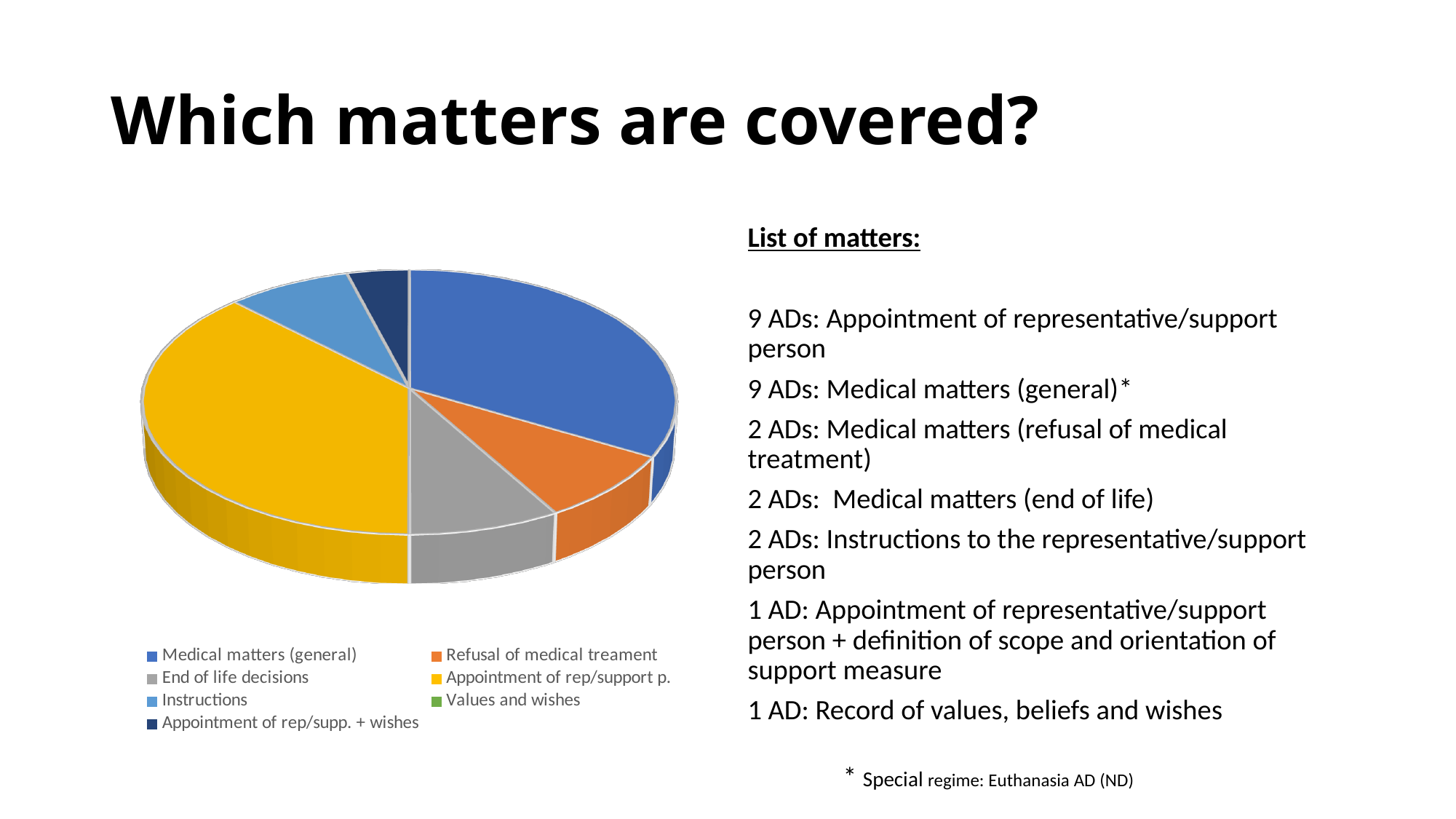
What is the title of the slide containing the pie chart? Which matters are covered? How many categories does the pie chart's legend list? 7 Which is larger in the pie chart: the slice for "End of life decisions" or the slice for "Appointment of rep/support p."? Appointment of rep/support p. What kind of chart is shown on the slide? pie chart Which is larger in the pie chart: the slice for "Appointment of rep/support p." or the slice for "Refusal of medical treament"? Appointment of rep/support p. Which colour represents "Appointment of rep/support p." in the pie chart? yellow Which is larger in the pie chart: the slice for "Medical matters (general)" or the slice for "Appointment of rep/supp. + wishes"? Medical matters (general)